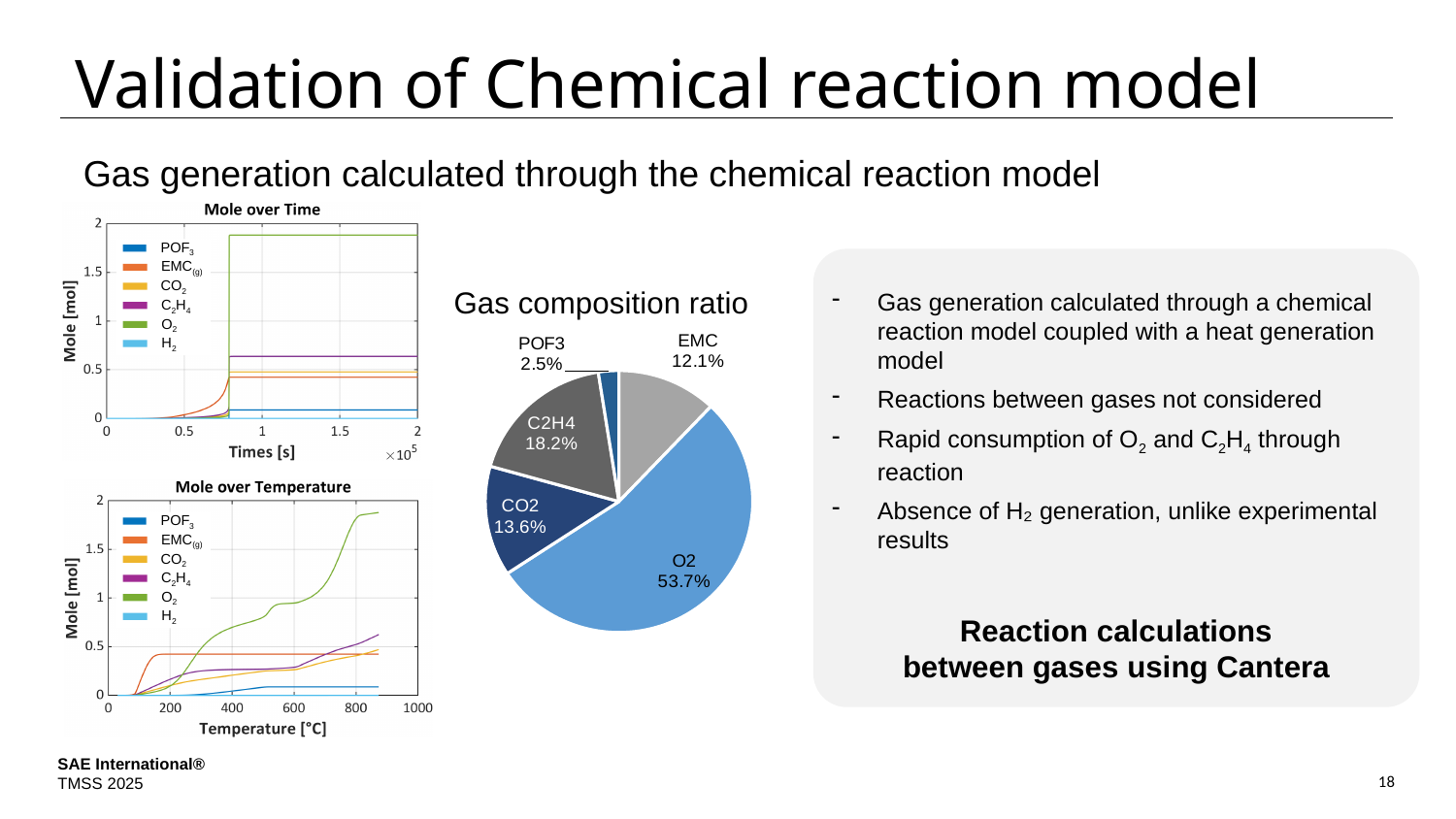
How many slices does the Gas composition ratio pie chart have? 5 What kind of chart is the Mole over Temperature chart? Line chart In the Gas composition ratio pie chart, what share does C2H4 have? 18.2% In the Mole over Time chart, is the final value of O2 greater or less than 1.5 mol? greater In the Gas composition ratio pie chart, which has a larger share, EMC or CO2? CO2 In the Gas composition ratio pie chart, which gas has the smallest share? POF3 In the Gas composition ratio pie chart, which gas has the largest share? O2 In the Gas composition ratio pie chart, what share does POF3 have? 2.5% In the Gas composition ratio pie chart, what share does O2 have? 53.7% How many series does the legend of the Mole over Time chart list? 6 In the Gas composition ratio pie chart, what is the difference between the shares of C2H4 and CO2? 4.6% What kind of chart is the Gas composition ratio chart? Pie chart